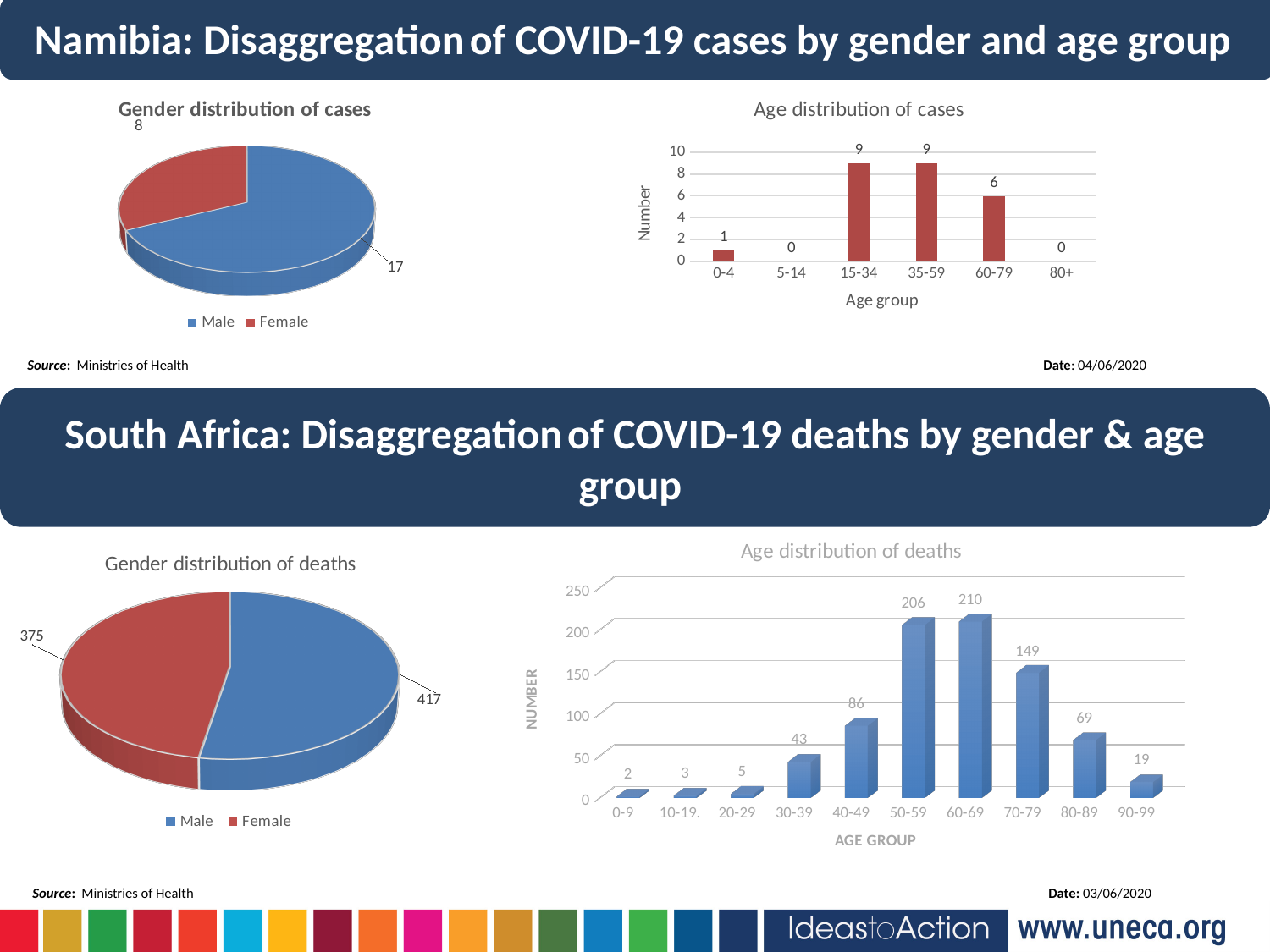
In the 'Age distribution of cases' chart for Namibia, how many age groups are shown on the x axis? 6 In the 'Gender distribution of deaths' pie chart for South Africa, how many deaths are Female? 375 In the 'Age distribution of deaths' chart for South Africa, which age group has the highest number of deaths? 60-69 In the 'Age distribution of deaths' chart for South Africa, what is the difference between the 50-59 and 40-49 age groups? 120 In the 'Age distribution of cases' chart for Namibia, what is the value for the 60-79 age group? 6 In the 'Gender distribution of cases' pie chart for Namibia, how many cases are Male? 17 In the 'Gender distribution of deaths' pie chart for South Africa, what is the difference between Male and Female deaths? 42 In the 'Gender distribution of cases' pie chart for Namibia, how many cases are Female? 8 In the 'Age distribution of deaths' chart for South Africa, what is the value for the 70-79 age group? 149 In the 'Age distribution of cases' chart for Namibia, which age groups have a value of 0? 5-14 and 80+ In the 'Age distribution of deaths' chart for South Africa, which is larger: the value for 80-89 or the value for 30-39? 80-89 What type of chart is the 'Age distribution of deaths' chart for South Africa? Bar chart